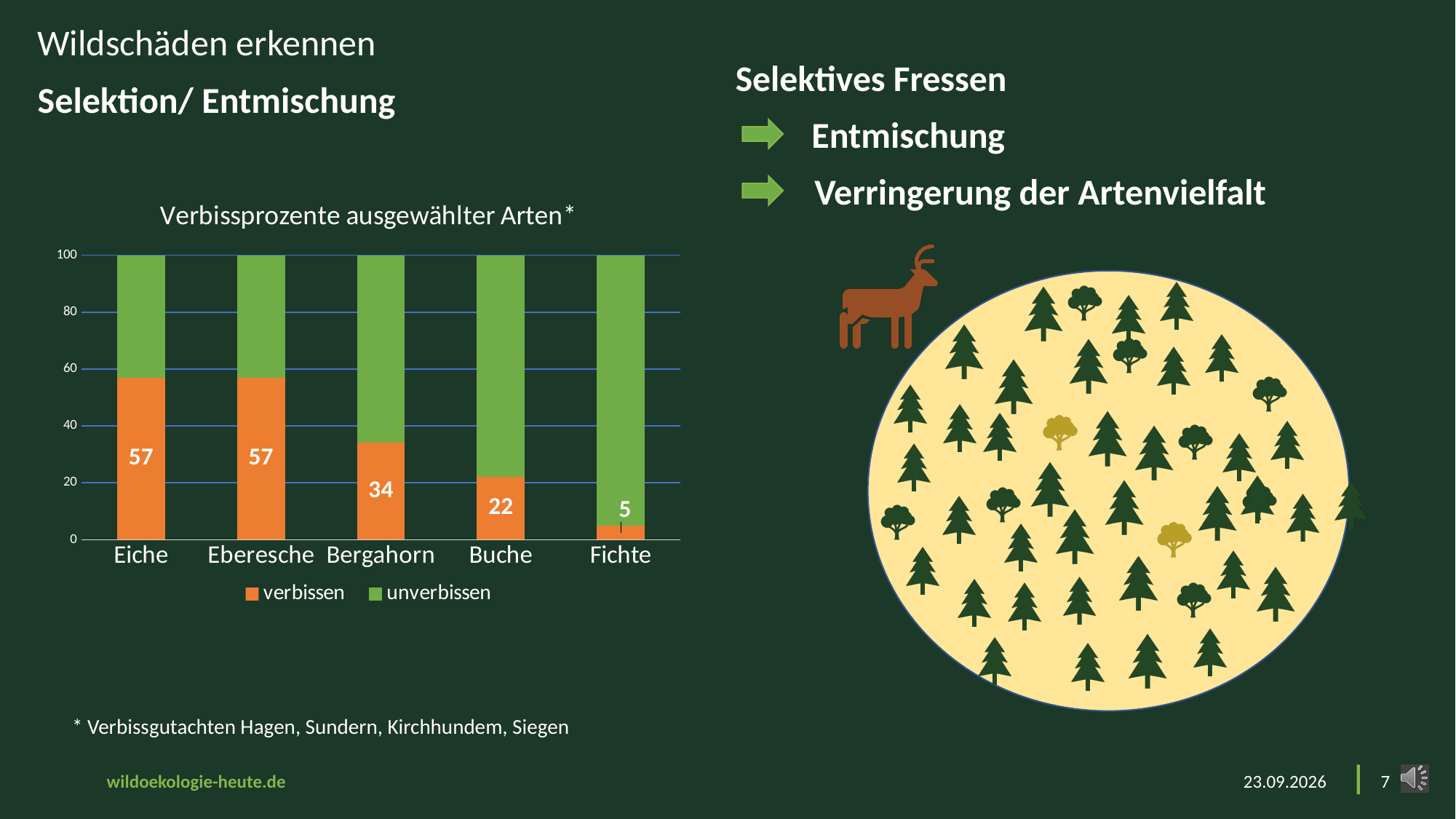
What is the difference between the 'verbissen' values for Eiche and Bergahorn? 23 What is the 'verbissen' value for Eiche? 57 What is the difference between the 'verbissen' values for Buche and Fichte? 17 How many series does the chart legend list? 2 Which has the larger 'verbissen' value, Bergahorn or Buche? Bergahorn What is the 'verbissen' value for Fichte? 5 What is the 'verbissen' value for Bergahorn? 34 What is the title of the chart? Verbissprozente ausgewählter Arten* How many species are shown on the x axis of the chart? 5 What kind of chart is shown on the slide? stacked bar chart Is the 'verbissen' value for Bergahorn greater or less than 40? less Which species has the lowest 'verbissen' value? Fichte